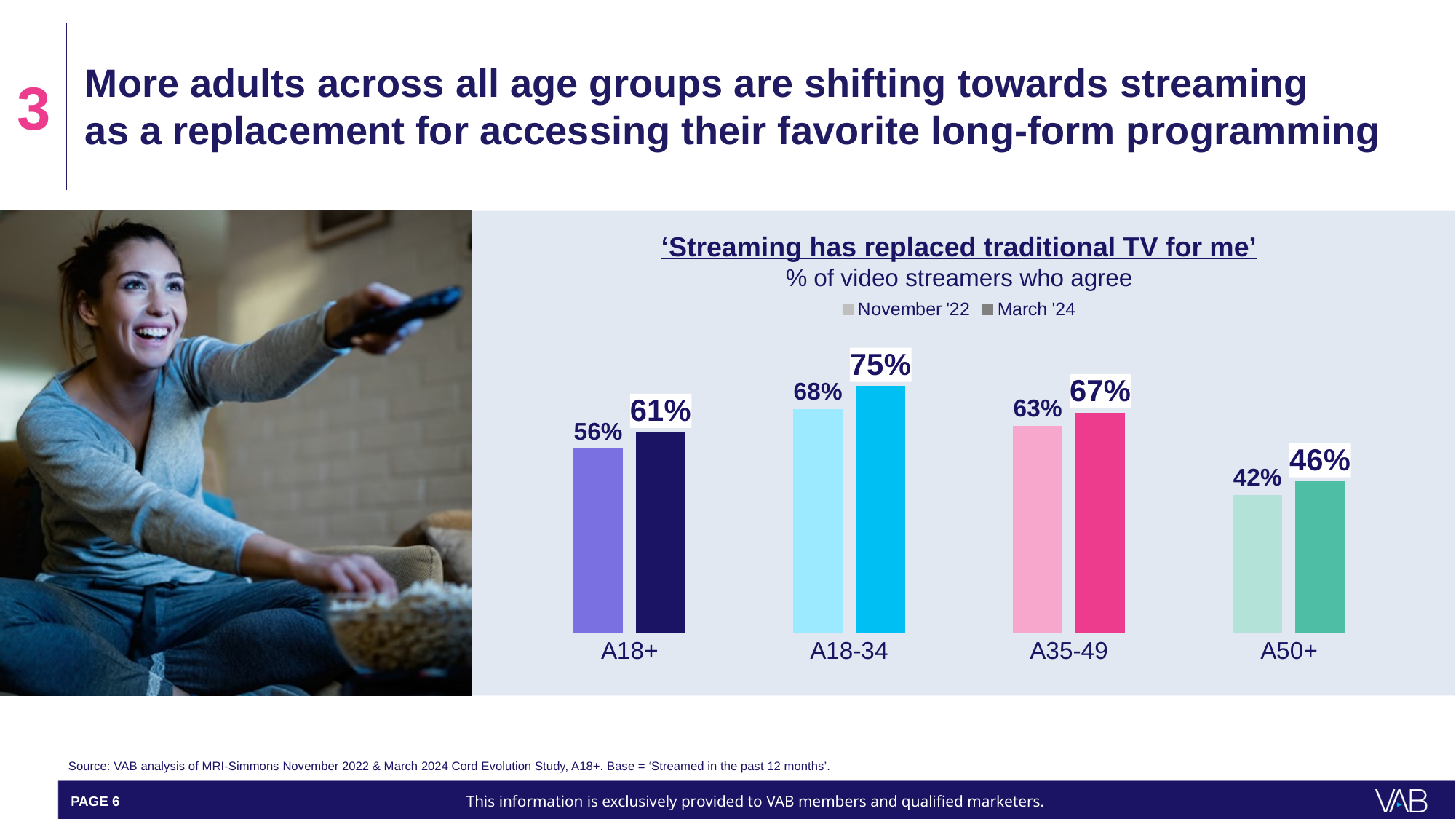
What is the difference between the March '24 values for A18-34 and A50+? 29% Which age group has the highest March '24 value? A18-34 Which is larger: the March '24 value for A35-49 or the November '22 value for A18-34? November '22 value for A18-34 What is the November '22 value for A50+? 42% What is the November '22 value for A35-49? 63% Which age group has the lowest November '22 value? A50+ What kind of chart is shown on the slide? Bar chart What is the March '24 value for A18-34? 75% How many age groups are shown on the x axis? 4 What is the March '24 value for A18+? 61% How many series does the legend list? 2 What is the difference between the March '24 and November '22 values for A18+? 5%